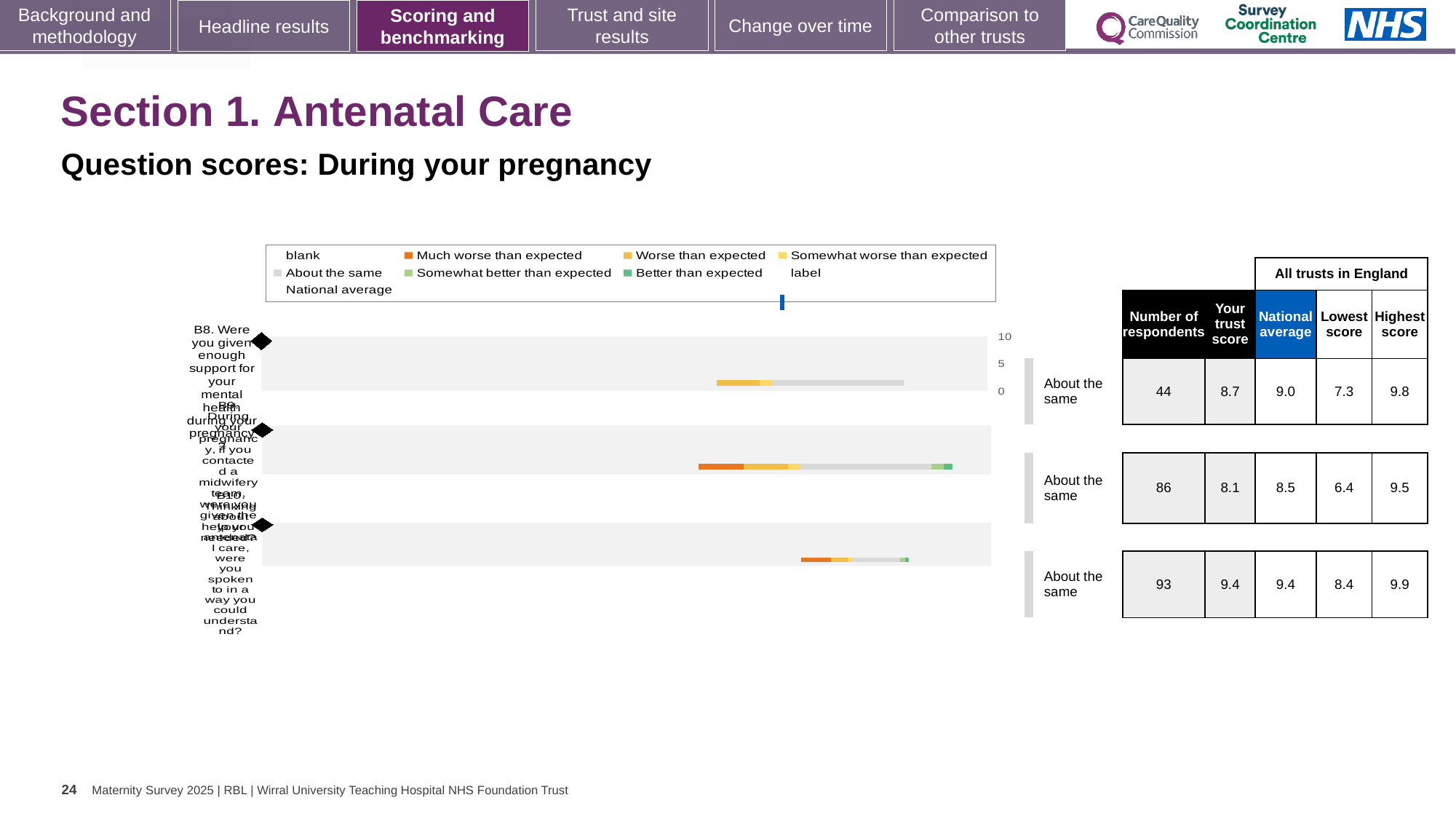
Which legend entry is shown in dark orange? Much worse than expected In the table, what is the lowest score for the second row? 6.4 In the table, what is the number of respondents for the first row (B8, support for your mental health during pregnancy)? 44 For the first row (B8), what is the difference between the national average and the trust score? 0.3 How many question rows are plotted in the chart? 3 In the table, what is the trust score for the first row (B8)? 8.7 For the second row, which is larger: the trust score or the national average? the national average In the table, what is the national average for the second row? 8.5 What benchmark category is shown next to each of the three rows? About the same In the table, what is the highest score for the third row? 9.9 What kind of chart is shown on the slide? bar chart Which row has the highest trust score in the table? the third row (9.4)